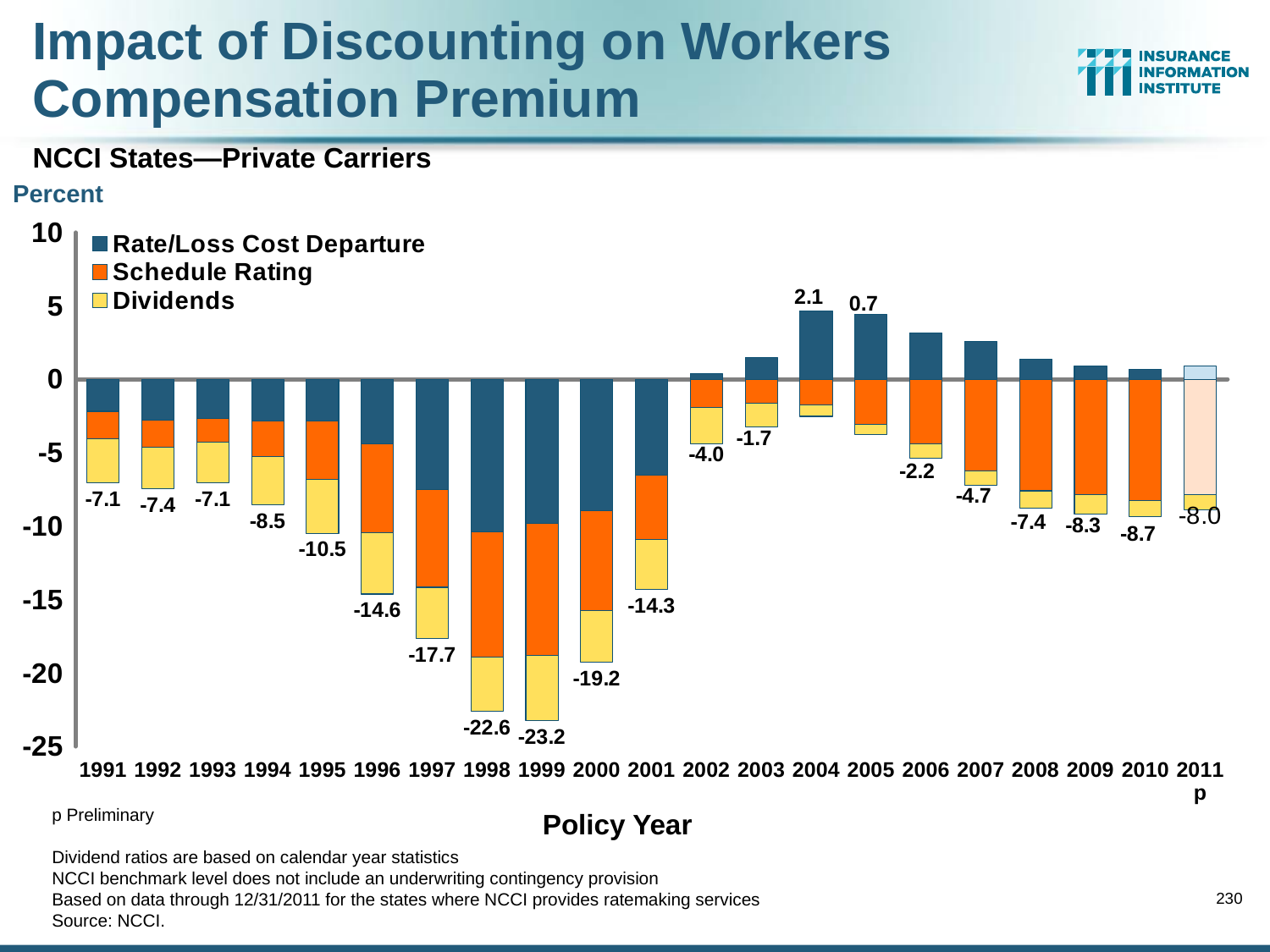
Do the labeled net values rise or fall from 1991 to 1999? Fall Which policy year has the lowest (most negative) labeled net value? 1999 Which legend entry is shown in yellow? Dividends What is the net value labeled for policy year 2011p? -8.0 What is the net value labeled for policy year 1999? -23.2 What is the net value labeled for policy year 2004? 2.1 How many series does the legend list? 3 What type of chart is shown on the slide? Stacked bar chart Which policy year has the highest labeled net value? 2004 What is the difference between the labeled net values for 1998 and 1999? 0.6 How many policy years are shown on the x axis? 21 Which policy year has a larger labeled net value, 2005 or 2006? 2005